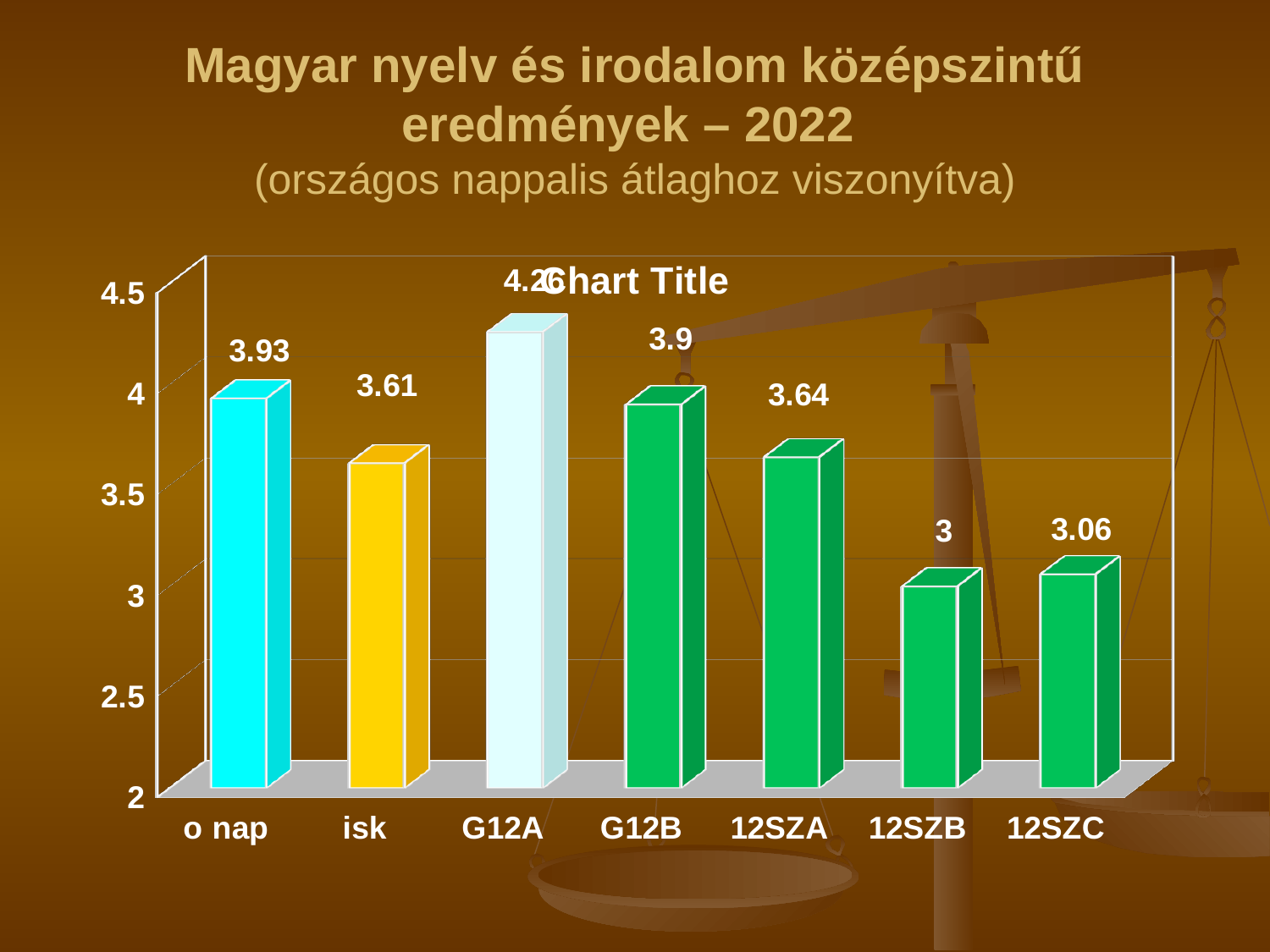
What is the value for G12B? 3.9 How many categories are shown on the x axis? 7 Which is larger, the value for G12B or the value for 12SZA? G12B What kind of chart is shown on the slide? bar chart Is the value for G12A greater or less than 4? greater What is the value for isk? 3.61 What is the value for o nap? 3.93 Which category has the lowest value? 12SZB What is the difference between the values for o nap and isk? 0.32 Which category has the highest value? G12A What is the value for 12SZC? 3.06 What is the value for 12SZA? 3.64